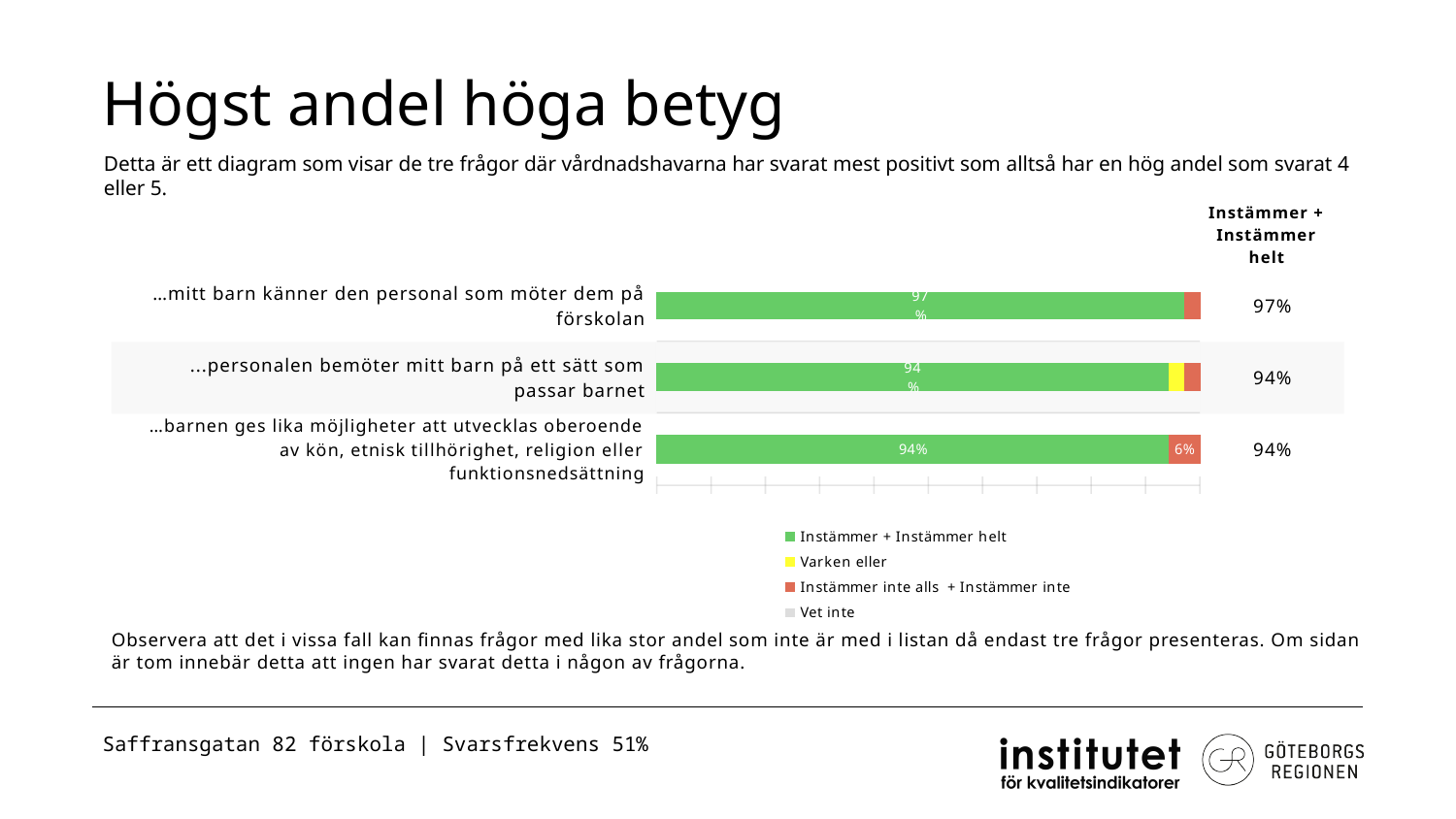
What is the 'Instämmer inte alls + Instämmer inte' share for '…barnen ges lika möjligheter att utvecklas oberoende av kön, etnisk tillhörighet, religion eller funktionsnedsättning'? 6% How many series does the legend list? 4 How many questions (categories) are shown in the chart? 3 What is the 'Instämmer + Instämmer helt' share for '…personalen bemöter mitt barn på ett sätt som passar barnet'? 94% Which colour represents 'Varken eller' in the legend? Yellow Which has a larger 'Instämmer + Instämmer helt' share: '…mitt barn känner den personal som möter dem på förskolan' or '…barnen ges lika möjligheter att utvecklas oberoende av kön, etnisk tillhörighet, religion eller funktionsnedsättning'? …mitt barn känner den personal som möter dem på förskolan What is the 'Instämmer + Instämmer helt' share for '…mitt barn känner den personal som möter dem på förskolan'? 97% What is the 'Instämmer + Instämmer helt' share for '…barnen ges lika möjligheter att utvecklas oberoende av kön, etnisk tillhörighet, religion eller funktionsnedsättning'? 94% What is the title of the slide containing the chart? Högst andel höga betyg Which question has the highest 'Instämmer + Instämmer helt' share? …mitt barn känner den personal som möter dem på förskolan What kind of chart is shown on the slide? Stacked bar chart What is the difference in 'Instämmer + Instämmer helt' share between '…mitt barn känner den personal som möter dem på förskolan' and '…personalen bemöter mitt barn på ett sätt som passar barnet'? 3 percentage points